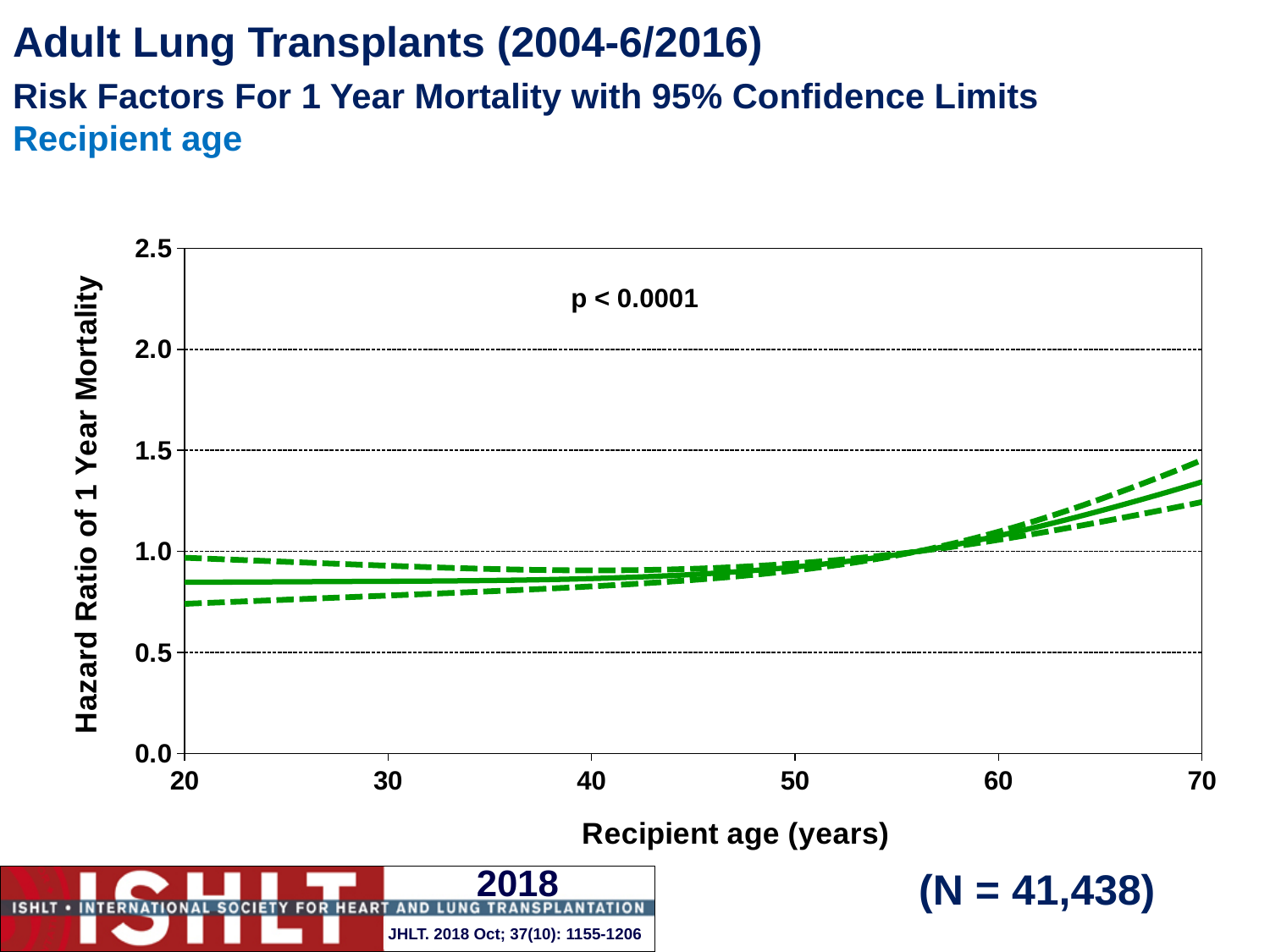
How many lines are plotted on the chart (the estimate plus its confidence limits)? 3 Is the hazard ratio (solid line) at a recipient age of 40 years greater or less than 1.0? less What kind of chart is shown on the slide? line chart Is the hazard ratio (solid line) at a recipient age of 70 years greater or less than 1.0? greater Which has the larger hazard ratio of 1 year mortality: a recipient age of 20 years or 70 years? 70 years Does the hazard ratio of 1 year mortality rise or fall as recipient age increases from 20 to 70 years? rises What is the label of the x axis? Recipient age (years) Is the lower 95% confidence limit at a recipient age of 20 years greater or less than 0.5? greater What p-value is printed on the chart? p < 0.0001